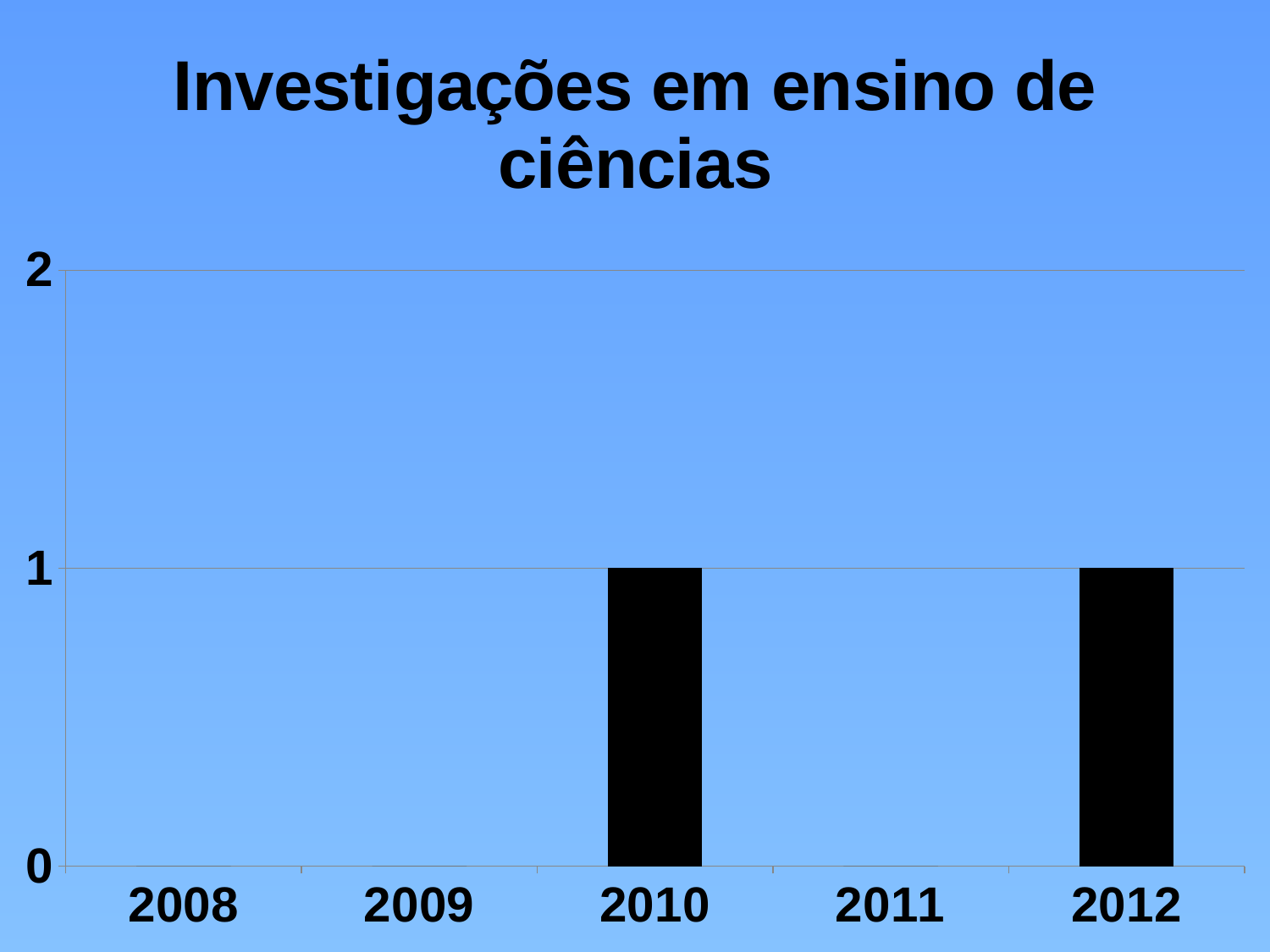
Is the value for 2010 greater or less than 2? less What is the title of the chart? Investigações em ensino de ciências What is the value for 2012? 1 How many years are shown on the x axis? 5 What is the value for 2011? 0 What is the value for 2010? 1 Which is larger, the value for 2012 or the value for 2008? 2012 What kind of chart is this? bar chart Which years have the highest value? 2010 and 2012 What is the value for 2009? 0 What is the highest value shown on the y axis? 2 What is the difference between the values for 2010 and 2011? 1